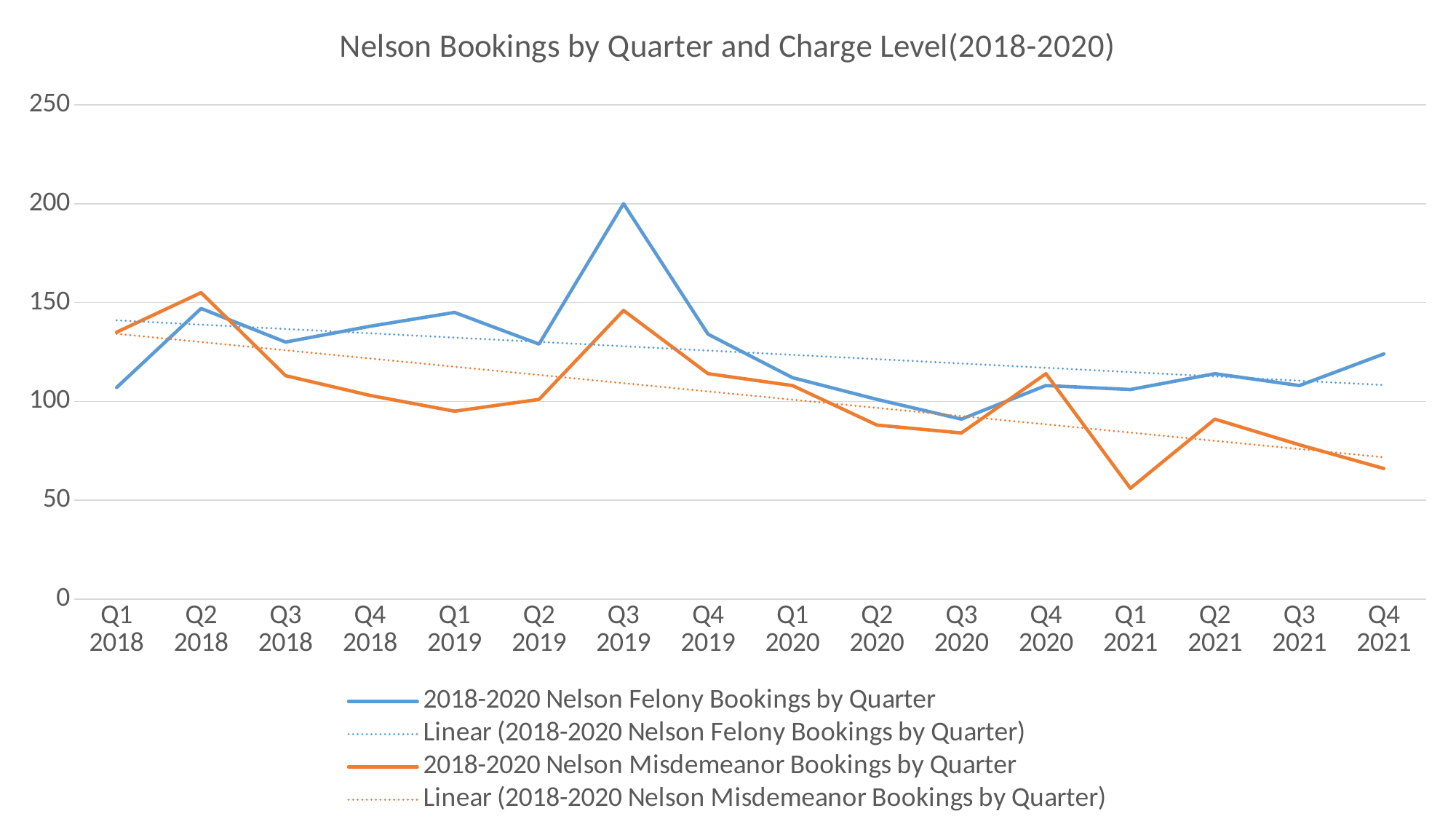
What kind of chart is shown on the slide? line chart What is the title of the chart? Nelson Bookings by Quarter and Charge Level(2018-2020) What is the value of 2018-2020 Nelson Felony Bookings by Quarter in Q3 2019? 200 How many quarters are plotted along the x axis? 16 Is the value of 2018-2020 Nelson Misdemeanor Bookings by Quarter in Q1 2021 greater or less than 100? less In which quarter do the 2018-2020 Nelson Felony Bookings by Quarter reach their highest value? Q3 2019 In Q2 2018, which series is higher: 2018-2020 Nelson Felony Bookings by Quarter or 2018-2020 Nelson Misdemeanor Bookings by Quarter? 2018-2020 Nelson Misdemeanor Bookings by Quarter Does the linear trendline for 2018-2020 Nelson Misdemeanor Bookings by Quarter rise or fall from left to right? fall How many entries does the legend list? 4 In Q4 2021, which series is higher: 2018-2020 Nelson Felony Bookings by Quarter or 2018-2020 Nelson Misdemeanor Bookings by Quarter? 2018-2020 Nelson Felony Bookings by Quarter In which quarter do the 2018-2020 Nelson Misdemeanor Bookings by Quarter reach their lowest value? Q1 2021 Is the value of 2018-2020 Nelson Felony Bookings by Quarter in Q2 2018 greater or less than 100? greater